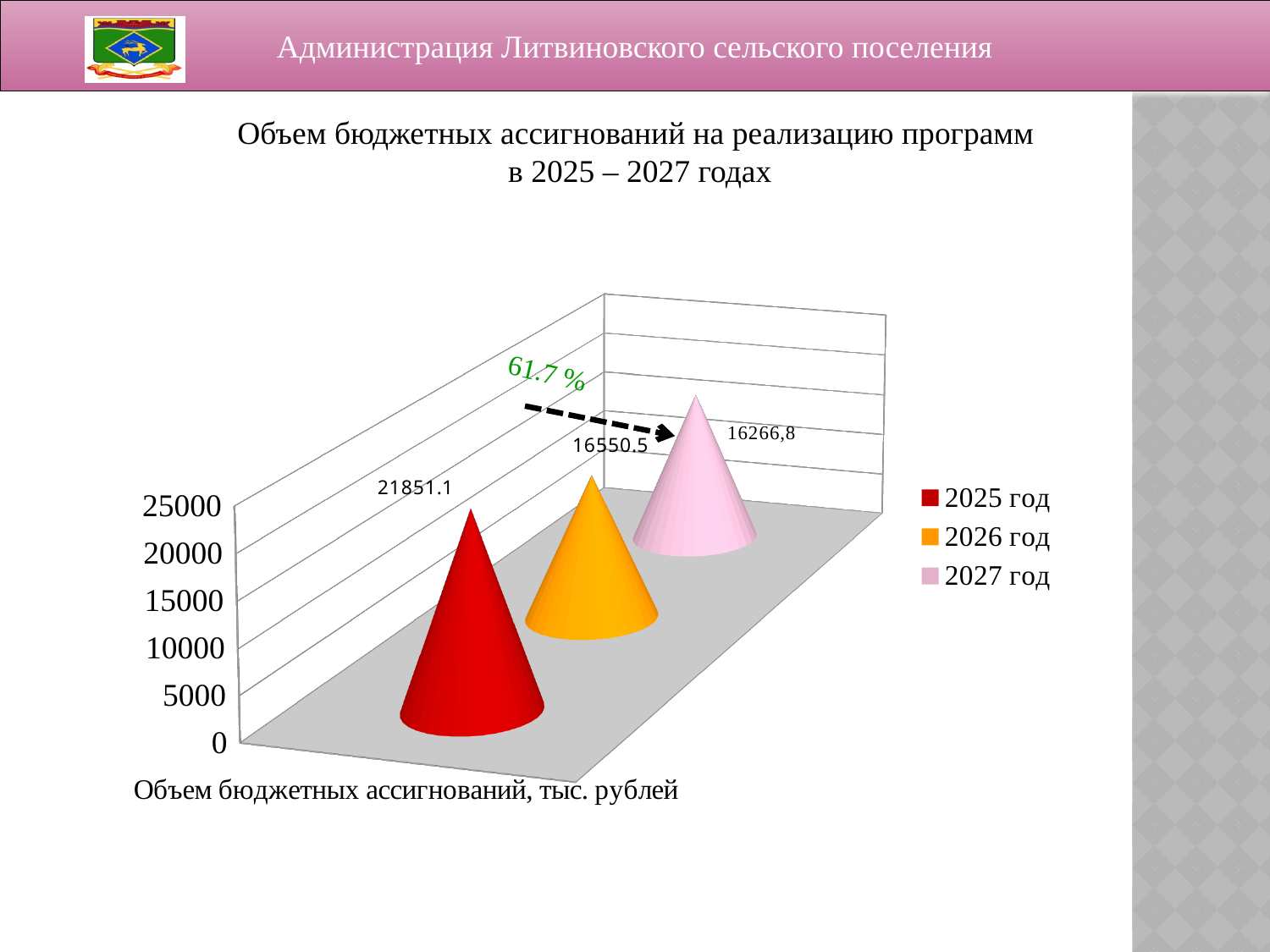
How many series does the legend list? 3 Which year has the lowest budget allocation? 2027 год What is the value for 2026 год? 16550.5 What is the difference between the values for 2025 год and 2026 год? 5300.6 Is the value for 2026 год greater or less than 20000? less Which year has the highest budget allocation? 2025 год Do the values rise or fall from 2025 to 2027? fall Which is larger, the value for 2025 год or the value for 2027 год? 2025 год What is the value for 2027 год? 16266,8 What percentage is written in the annotation above the chart? 61.7 % What is the value for 2025 год? 21851.1 What is the difference between the values for 2026 год and 2027 год? 283.7